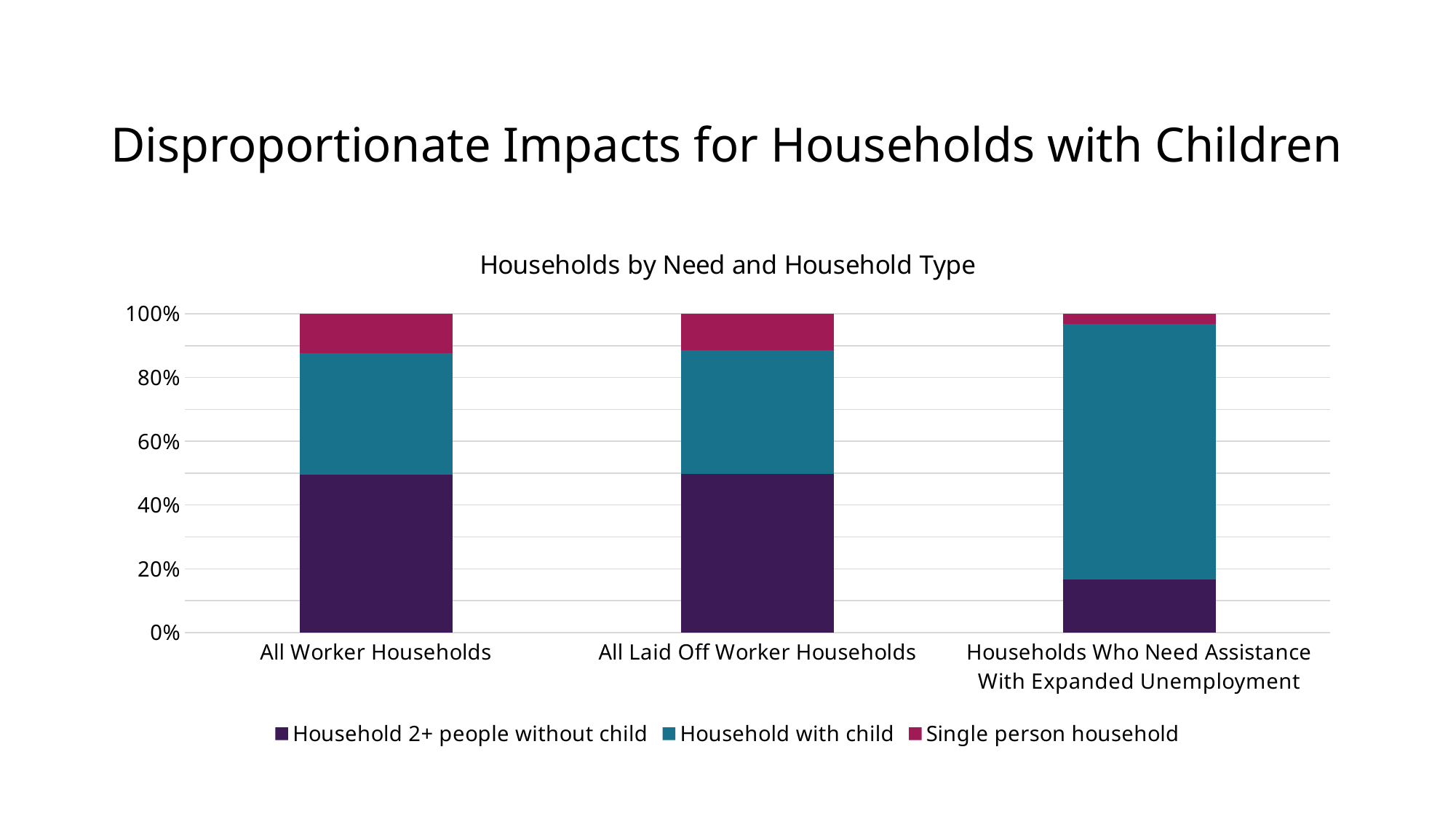
How many series does the chart's legend list? 3 Is the 'Household 2+ people without child' share for Households Who Need Assistance With Expanded Unemployment greater or less than 20%? less Which category has the smallest 'Household 2+ people without child' segment? Households Who Need Assistance With Expanded Unemployment Is the 'Household 2+ people without child' share for All Worker Households greater or less than 40%? greater What is the title of the chart? Households by Need and Household Type How many categories are shown on the x axis of the chart? 3 Which series is shown in the teal colour in the chart? Household with child Which category has the smallest 'Single person household' segment? Households Who Need Assistance With Expanded Unemployment Which category has the largest 'Household with child' segment? Households Who Need Assistance With Expanded Unemployment Is the 'Household with child' share for Households Who Need Assistance With Expanded Unemployment greater or less than 60%? greater Which is larger: the 'Household 2+ people without child' share for All Worker Households or for Households Who Need Assistance With Expanded Unemployment? All Worker Households What kind of chart is shown on the slide? Stacked bar chart